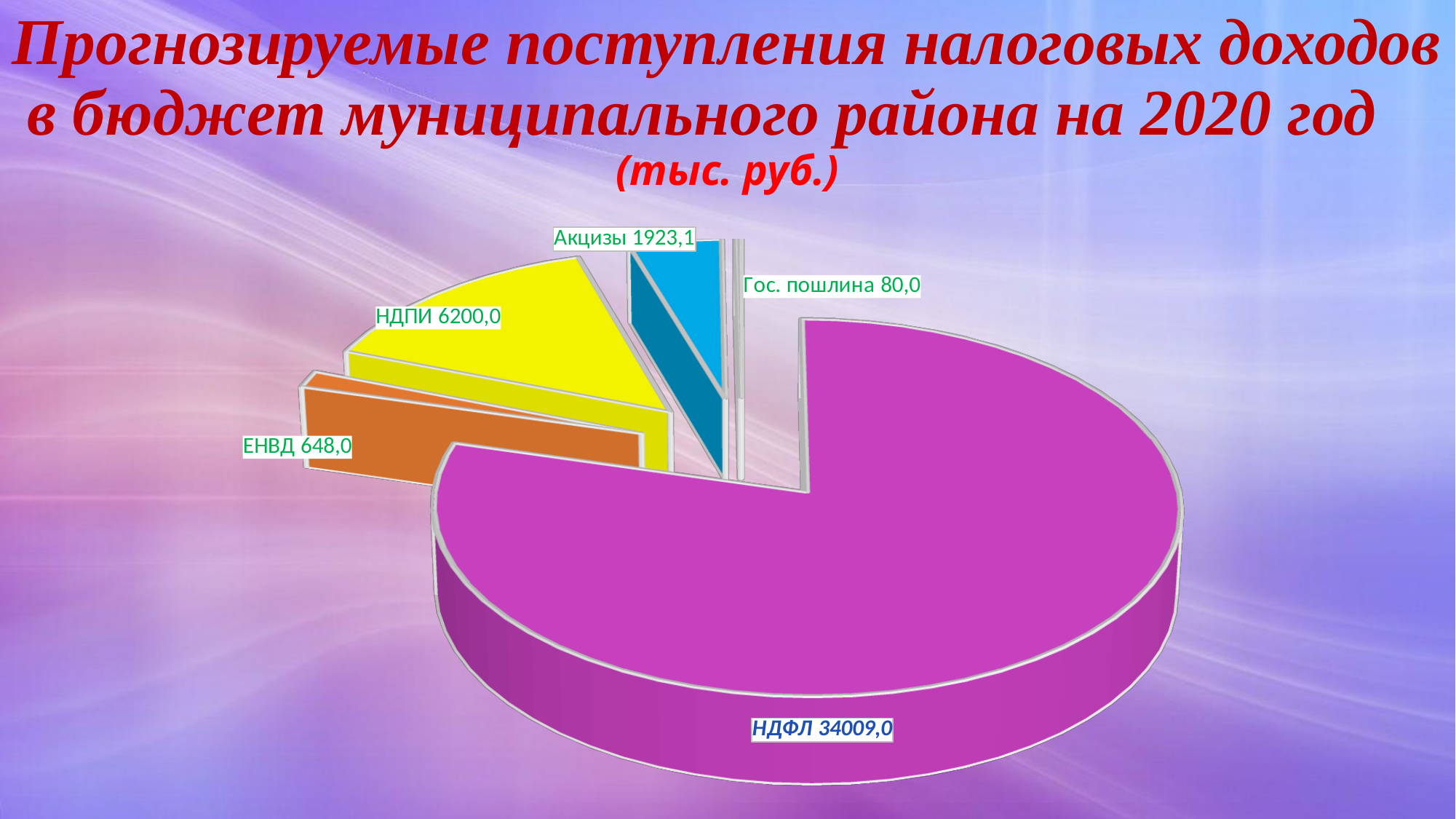
What is the difference between the values for НДПИ and Акцизы? 4276,9 How many slices does the pie chart have? 6 Which is larger, НДПИ or Акцизы? НДПИ What is the value for НДФЛ? 34009,0 What is the value for Гос. пошлина? 80,0 What unit of measurement is stated in the chart title? тыс. руб. What is the value for ЕНВД? 648,0 Which category has the largest value? НДФЛ What type of chart is shown on the slide? pie chart What is the value for НДПИ? 6200,0 What is the value for Акцизы? 1923,1